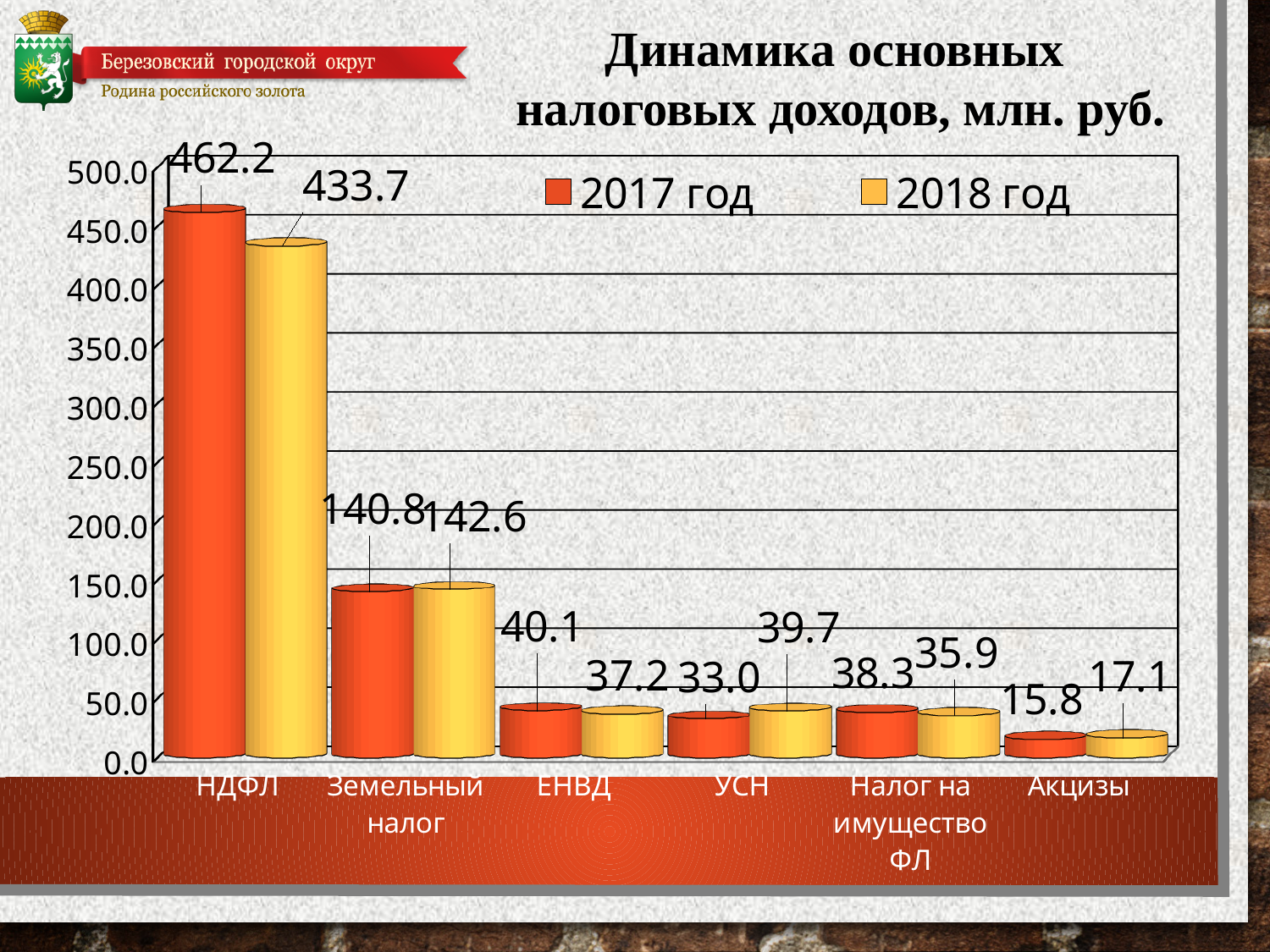
How many categories are shown on the x axis? 6 What is the value for УСН in 2018 год? 39.7 Which is larger for УСН: the 2017 год value or the 2018 год value? 2018 год What is the value for Земельный налог in 2018 год? 142.6 Which category has the lowest value in 2017 год? Акцизы What is the difference between the 2017 год and 2018 год values for НДФЛ? 28.5 What is the title of the chart? Динамика основных налоговых доходов, млн. руб. What kind of chart is shown on the slide? bar chart What is the value for НДФЛ in 2017 год? 462.2 Which category has the highest value in 2018 год? НДФЛ What is the value for Акцизы in 2017 год? 15.8 How many series does the legend list? 2